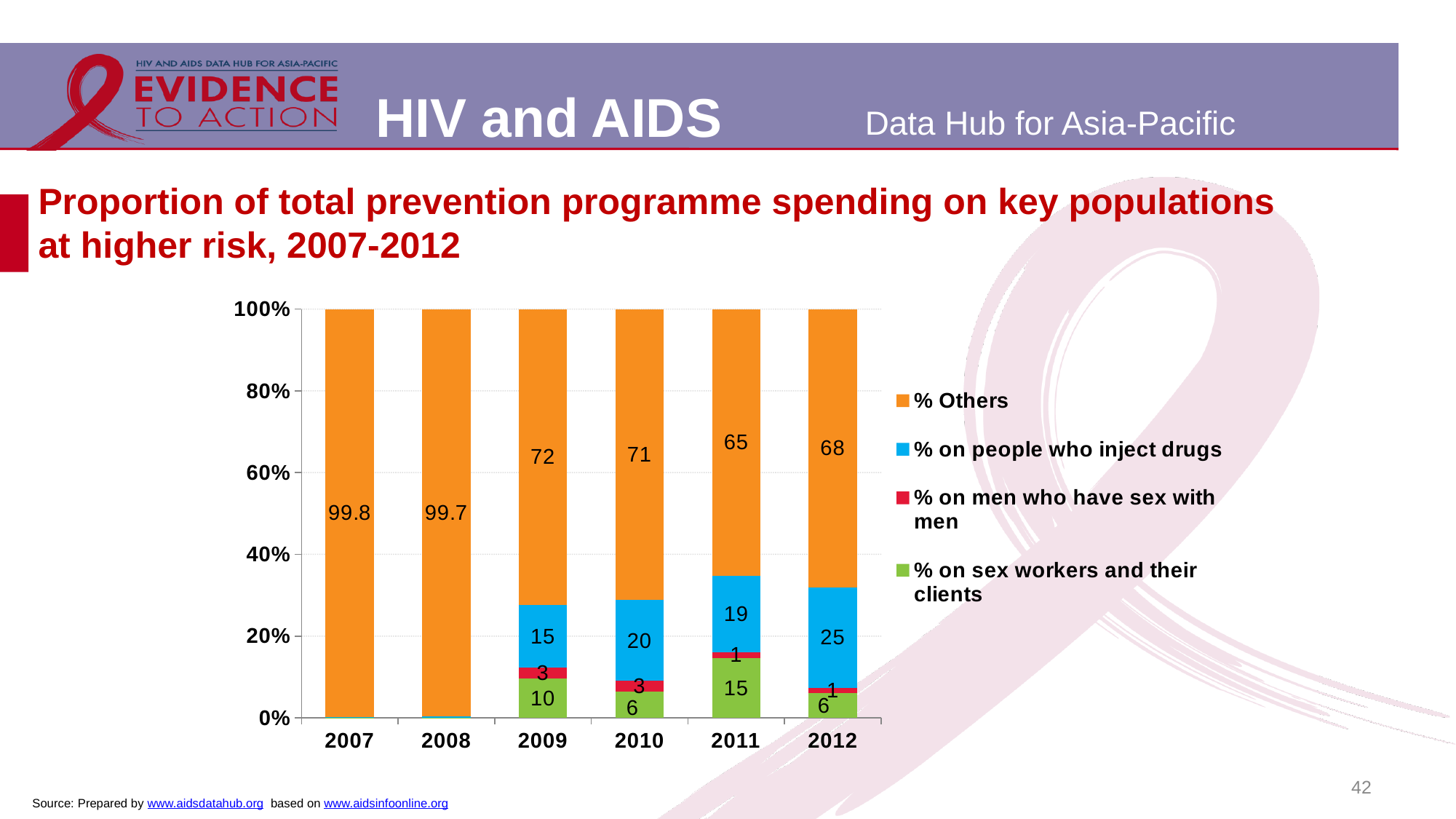
What is the value for % on people who inject drugs in 2012? 25 Which colour represents % Others in the chart? Orange In which year is the value for % on people who inject drugs highest? 2012 Among the years with a printed label, in which year is the value for % Others lowest? 2011 What is the value for % on sex workers and their clients in 2011? 15 What is the difference between the % Others values for 2009 and 2012? 4 Which is larger, the % on sex workers and their clients value in 2009 or in 2010? 2009 How many series does the legend list? 4 What kind of chart is shown on the slide? Stacked bar chart What is the value for % on men who have sex with men in 2010? 3 How many years are shown on the x axis? 6 What is the value for % Others in 2007? 99.8